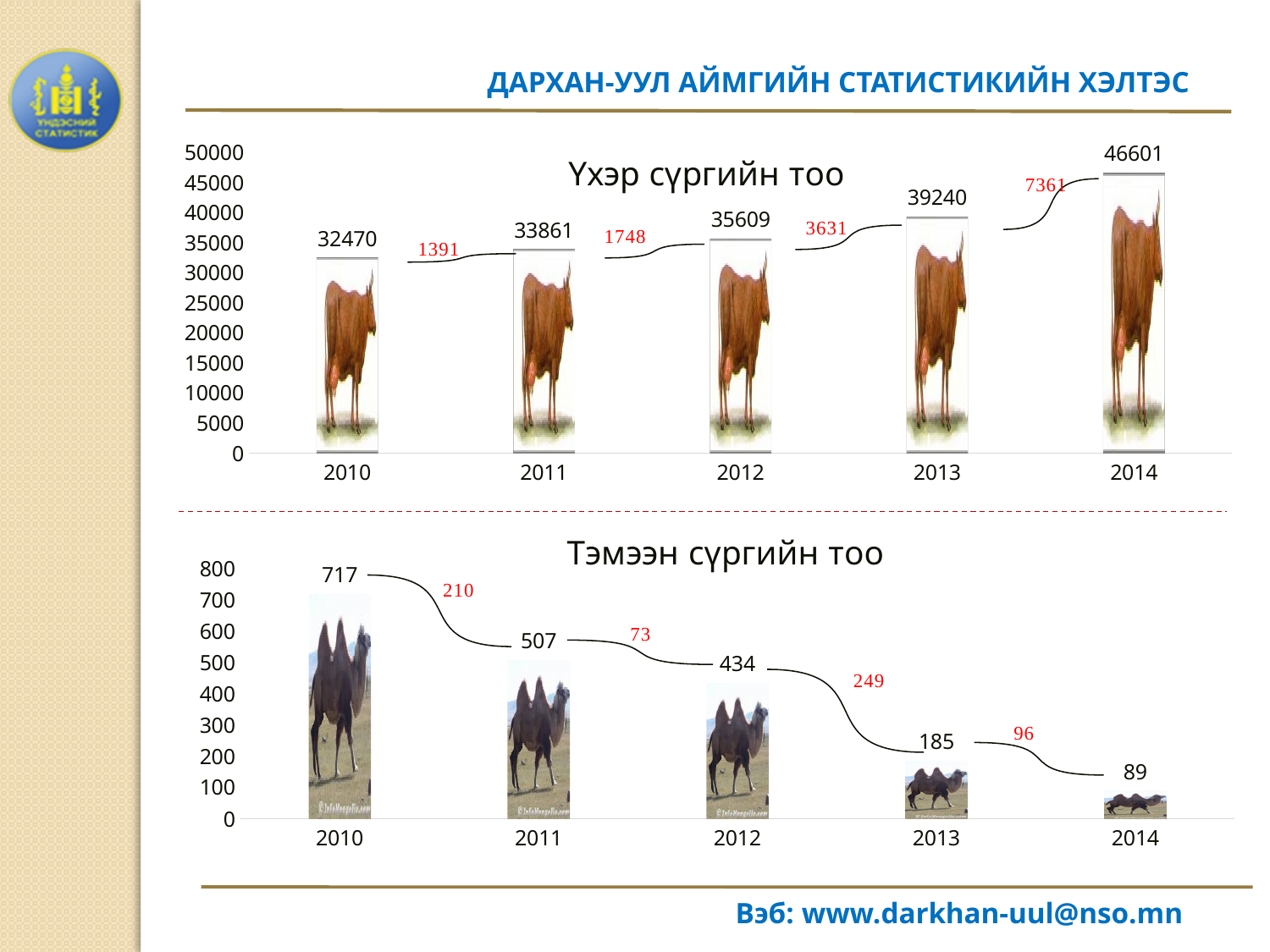
In the top chart titled "Үхэр сүргийн тоо", what is the value for 2014? 46601 In the bottom chart titled "Тэмээн сүргийн тоо", which is larger, the value for 2011 or the value for 2012? 2011 In the bottom chart titled "Тэмээн сүргийн тоо", do the values rise or fall from 2010 to 2014? fall In the bottom chart titled "Тэмээн сүргийн тоо", what is the value for 2013? 185 In the top chart titled "Үхэр сүргийн тоо", which year has the highest value? 2014 In the top chart titled "Үхэр сүргийн тоо", what is the difference between the 2013 and 2012 values? 3631 In the top chart titled "Үхэр сүргийн тоо", how many years are shown on the x axis? 5 In the top chart titled "Үхэр сүргийн тоо", do the values rise or fall from 2010 to 2014? rise In the bottom chart titled "Тэмээн сүргийн тоо", which year has the lowest value? 2014 What kind of chart is the bottom chart titled "Тэмээн сүргийн тоо"? bar chart In the top chart titled "Үхэр сүргийн тоо", what is the value for 2010? 32470 In the bottom chart titled "Тэмээн сүргийн тоо", what is the difference between the 2010 and 2011 values? 210